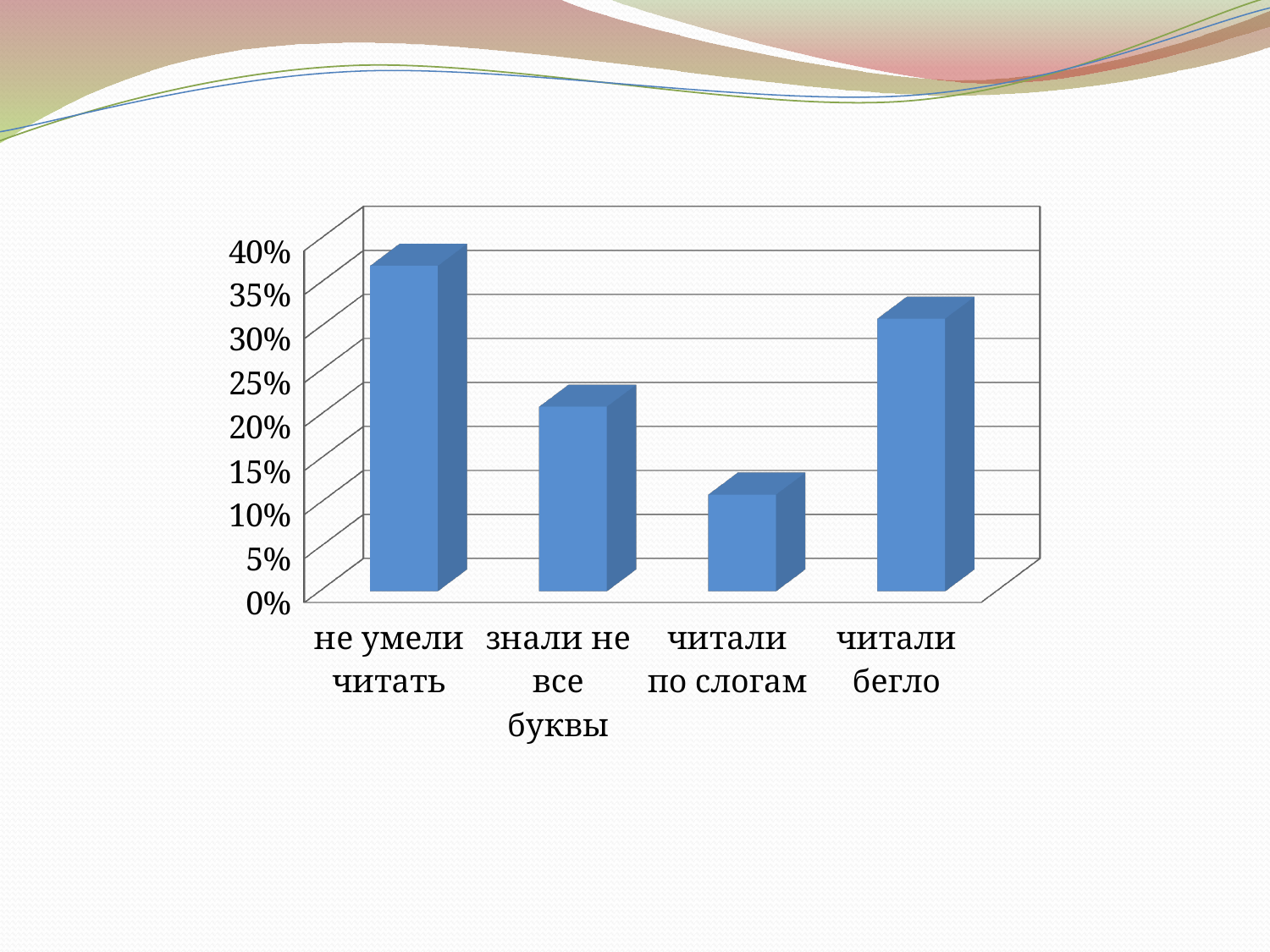
How many categories are shown on the x axis of the chart? 4 Which category has the lowest bar? читали по слогам Which is larger, the value for "не умели читать" or the value for "читали бегло"? не умели читать Is the value for "знали не все буквы" greater or less than 25%? less Which is larger, the value for "знали не все буквы" or the value for "читали по слогам"? знали не все буквы Is the value for "читали бегло" greater or less than 25%? greater Is the value for "не умели читать" greater or less than 30%? greater What kind of chart is shown on the slide? bar chart What is the highest value shown on the vertical axis of the chart? 40% What colour are the bars in the chart? blue Which category has the highest bar? не умели читать